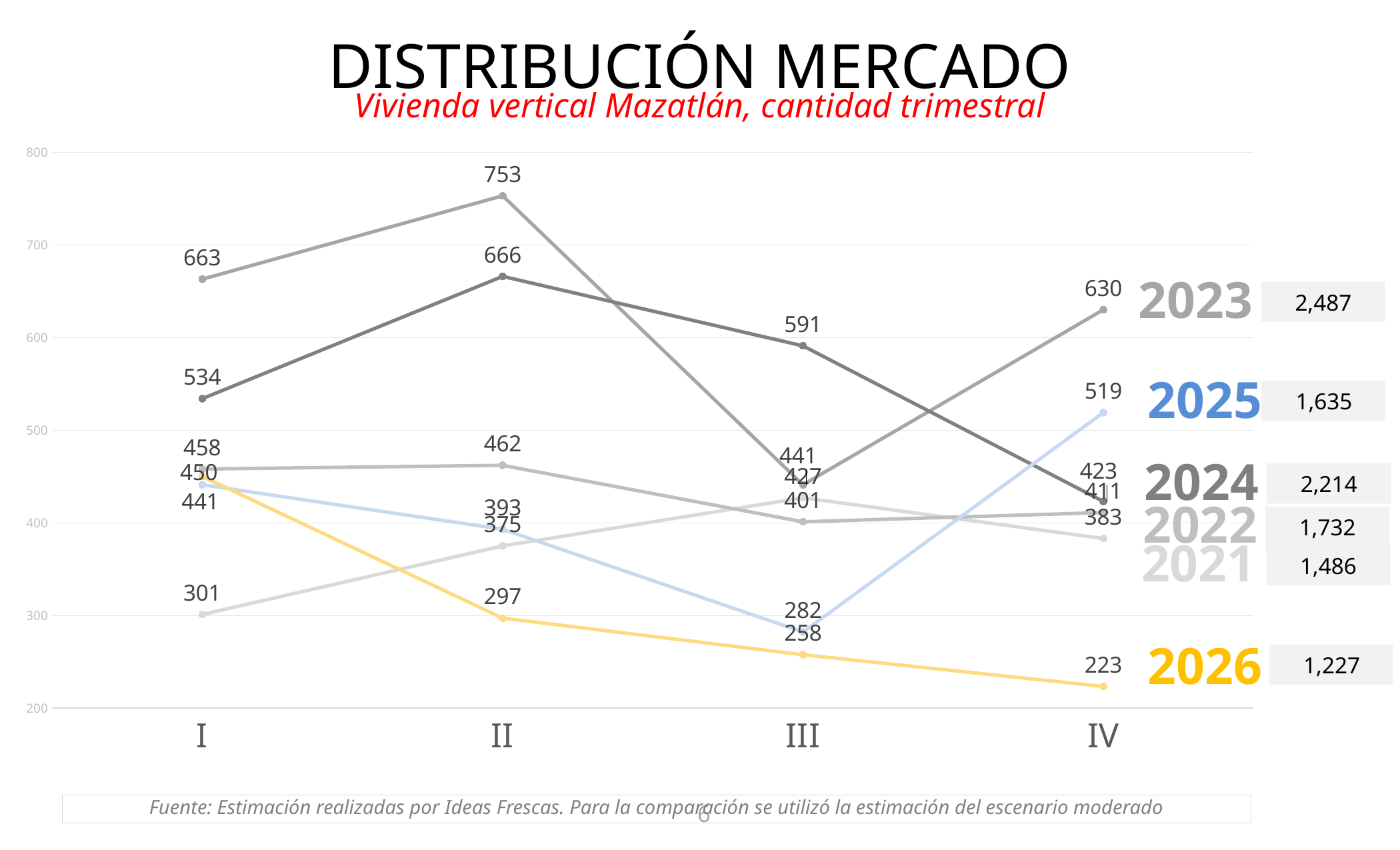
What kind of chart is shown on the slide? line chart Does the 2026 (yellow) line rise or fall from quarter I to quarter IV? fall What is the value of the 2025 (blue) line in quarter III? 282 What annual total is shown next to the 2023 label? 2,487 What is the highest value plotted on the chart, and in which quarter does it occur? 753, quarter II What is the lowest value plotted on the chart? 223 How many years (series) are listed on the right side of the chart? 6 What is the value of the 2025 (blue) line in quarter IV? 519 Which year has the larger annual total, 2024 or 2022? 2024 What is the difference between the 2025 line's quarter IV value (519) and its quarter III value (282)? 237 How many quarters are shown on the x axis? 4 What is the value of the 2026 (yellow) line in quarter IV? 223